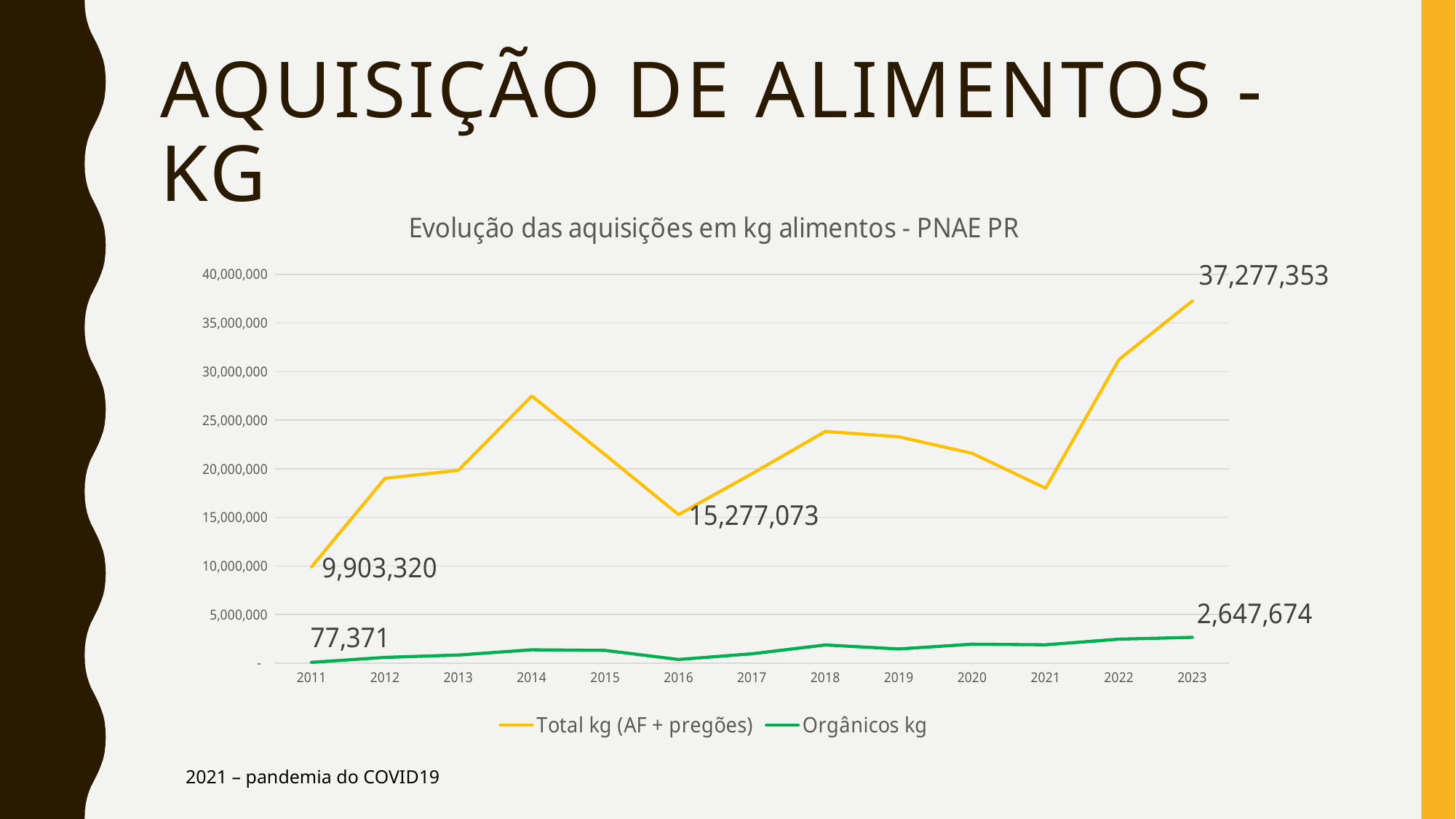
Is the value for Total kg (AF + pregões) in 2014 greater or less than 25,000,000? greater How many years are shown on the x axis? 13 What is the value of Orgânicos kg in 2023? 2,647,674 What is the value of Total kg (AF + pregões) in 2016? 15,277,073 What is the value of Orgânicos kg in 2011? 77,371 How many series does the legend list? 2 What is the difference between Total kg (AF + pregões) in 2023 and in 2011? 27,374,033 In which year is Total kg (AF + pregões) highest? 2023 What is the value of Total kg (AF + pregões) in 2011? 9,903,320 What is the value of Total kg (AF + pregões) in 2023? 37,277,353 What is the title of the chart? Evolução das aquisições em kg alimentos - PNAE PR What type of chart is shown on the slide? line chart